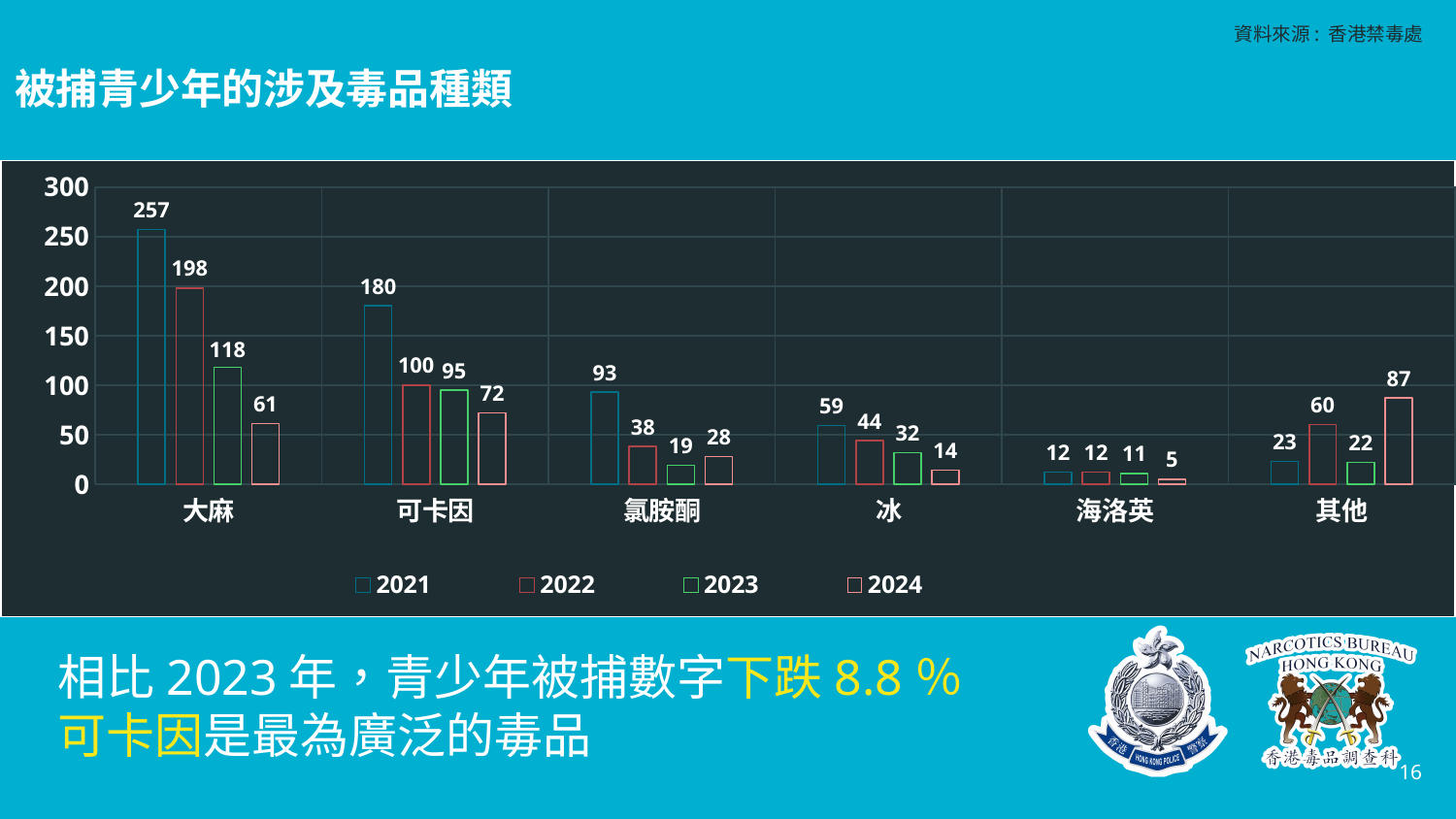
What is the title of the chart? 被捕青少年的涉及毒品種類 Which category has the lowest value in 2021? 海洛英 What is the value for 大麻 in 2021? 257 Which is larger: the 2023 value for 氯胺酮 or the 2024 value for 氯胺酮? 2024 value for 氯胺酮 What is the value for 可卡因 in 2024? 72 How many categories are shown on the x axis? 6 What is the value for 其他 in 2022? 60 What is the difference between the 2021 and 2024 values for 大麻? 196 Is the 2022 value for 可卡因 greater or less than 150? less How many series does the legend list? 4 Which category has the highest value in 2024? 其他 What kind of chart is shown on the slide? bar chart